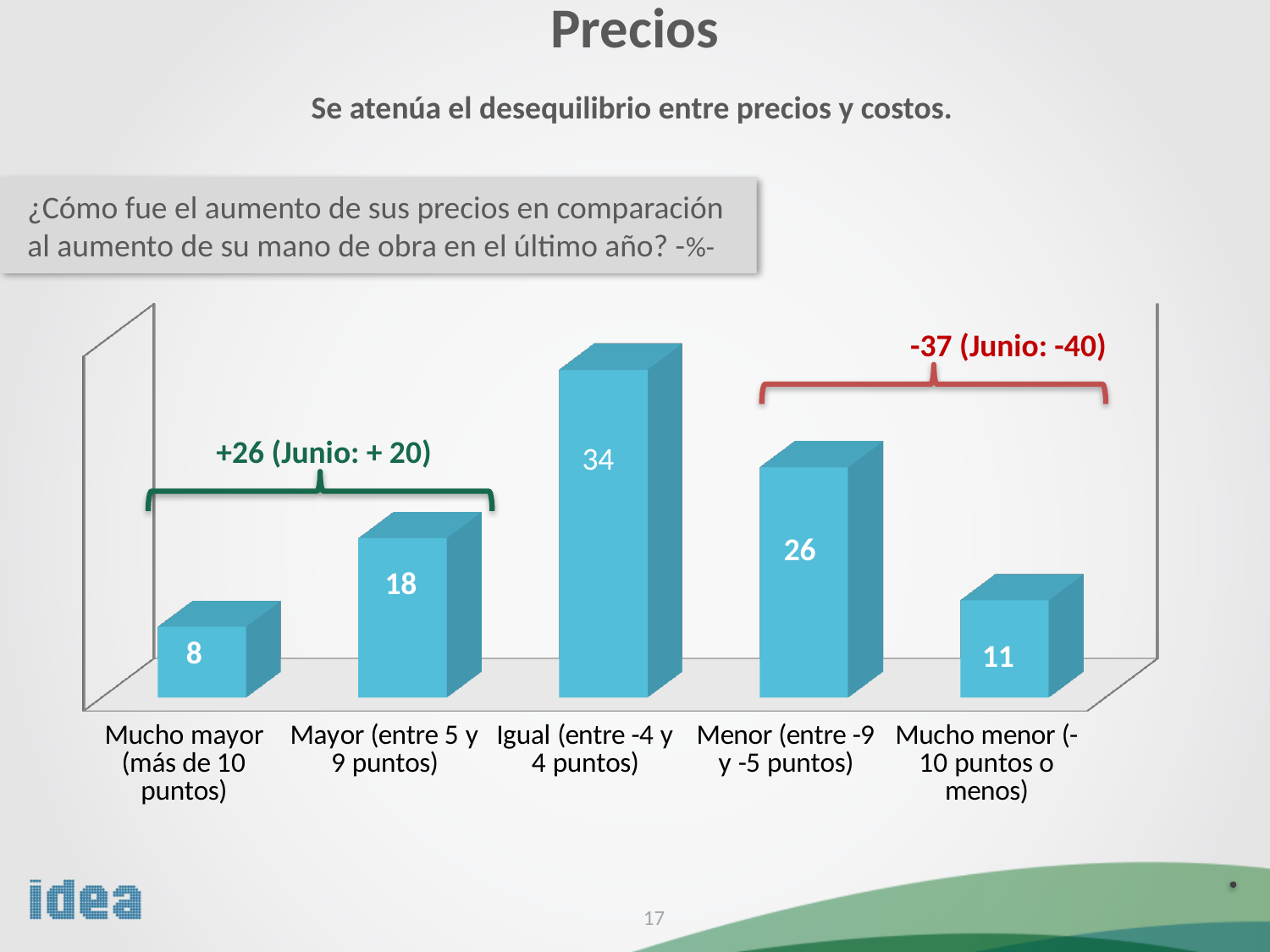
What kind of chart is shown on the slide? Bar chart What is the total of the values for "Mucho mayor (más de 10 puntos)" and "Mayor (entre 5 y 9 puntos)"? 26 What does the red bracket annotation above the two rightmost bars say? -37 (Junio: -40) Which is larger, the value for "Mayor (entre 5 y 9 puntos)" or the value for "Mucho menor (-10 puntos o menos)"? Mayor (entre 5 y 9 puntos) How many categories are shown on the chart? 5 What is the value for "Mucho menor (-10 puntos o menos)"? 11 Which category has the lowest value? Mucho mayor (más de 10 puntos) What is the value for "Menor (entre -9 y -5 puntos)"? 26 Which category has the highest value? Igual (entre -4 y 4 puntos) What is the value for "Igual (entre -4 y 4 puntos)"? 34 What is the value for "Mucho mayor (más de 10 puntos)"? 8 What is the difference between the values for "Igual (entre -4 y 4 puntos)" and "Menor (entre -9 y -5 puntos)"? 8